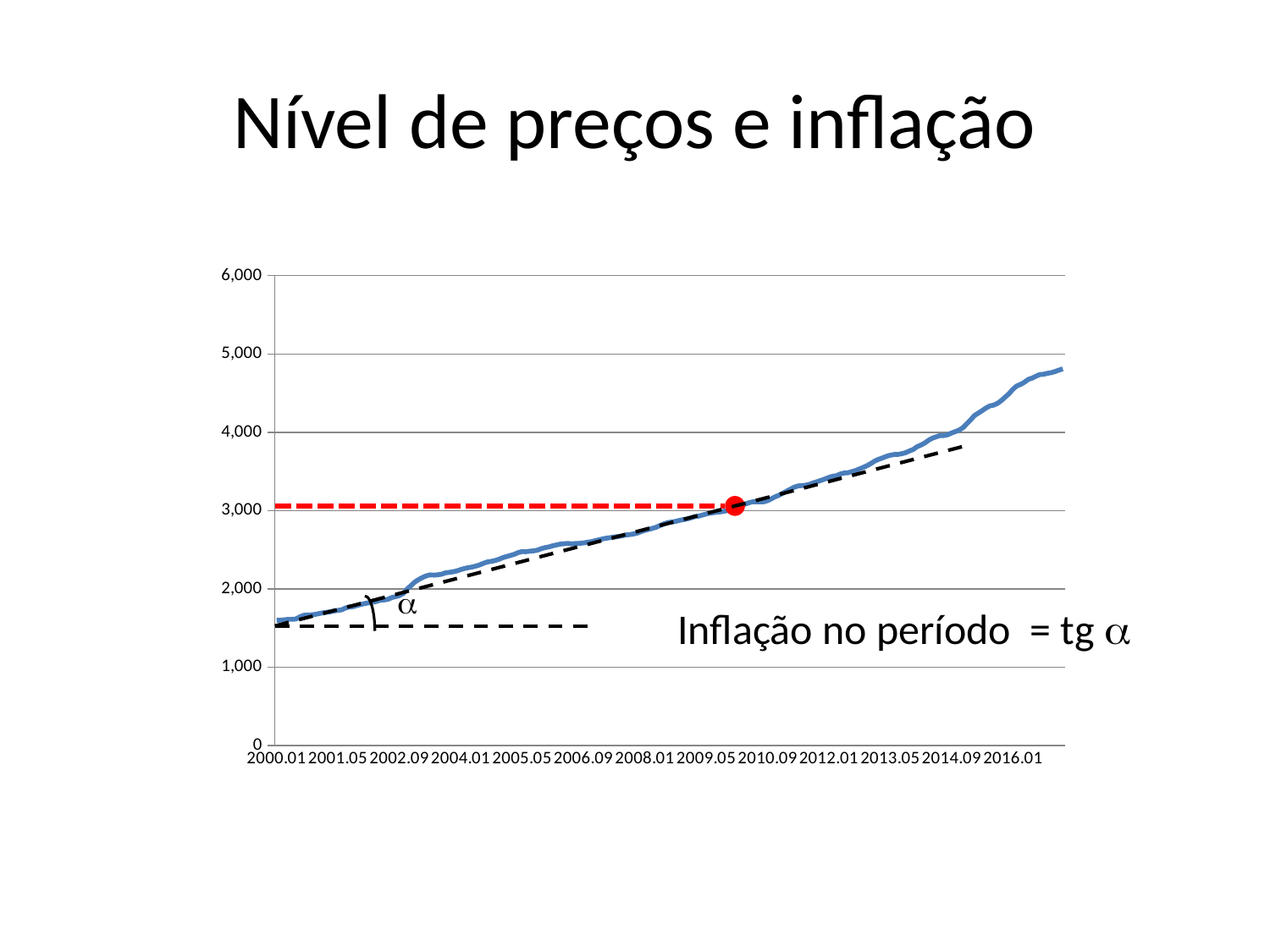
Is the value at 2005.05 greater or less than 3,000? less Is the value at 2012.01 greater or less than 3,000? greater Is the value at 2016.01 greater or less than 4,000? greater What kind of chart is shown on the slide? line chart At which labelled x-axis point is the plotted value lowest? 2000.01 What is the title of the slide containing the chart? Nível de preços e inflação How many labels are shown on the x axis? 13 Does the plotted price level rise or fall from 2000.01 to 2016.01? rise Which has the larger value, 2000.01 or 2016.01? 2016.01